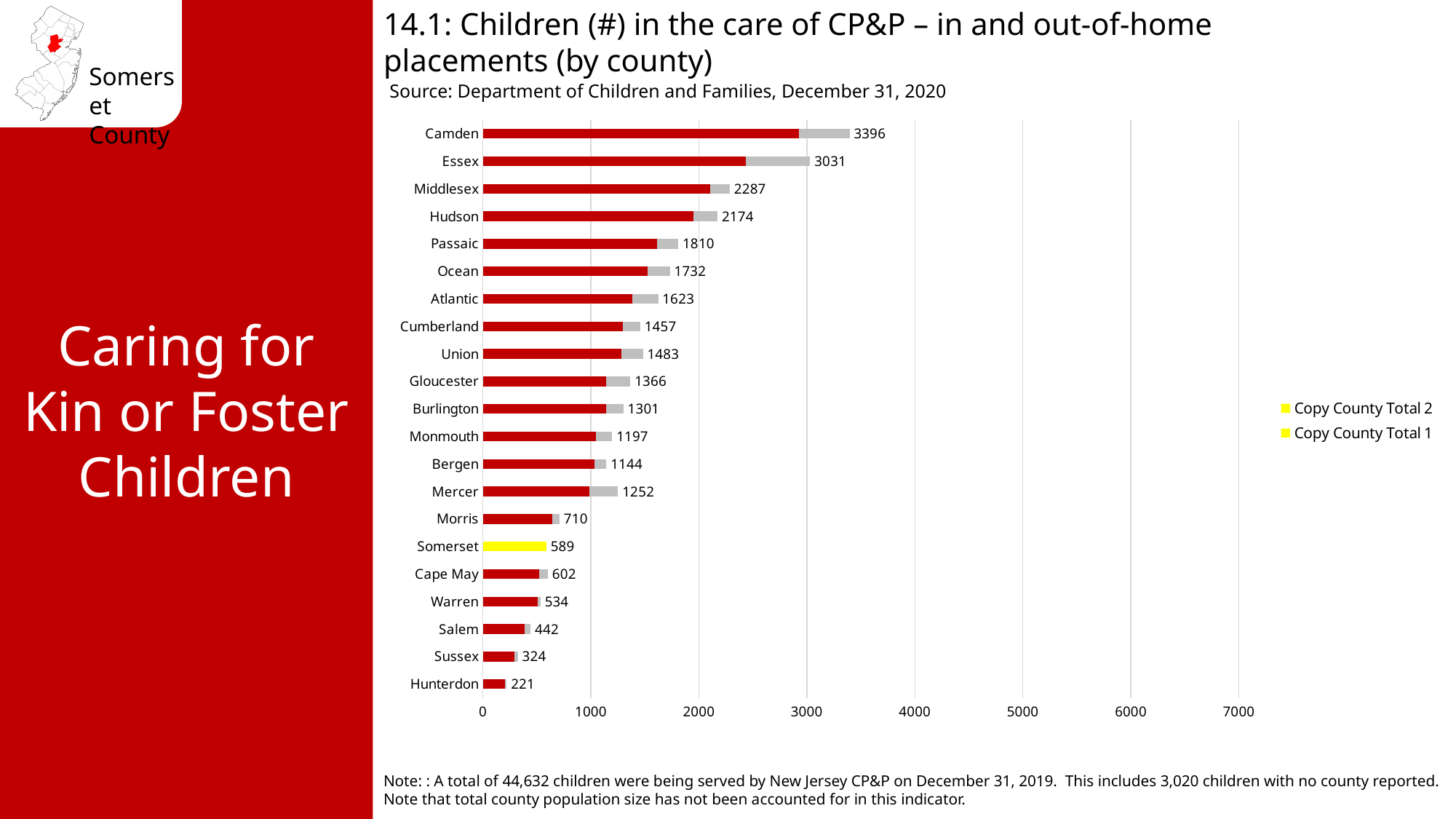
What is the total number of children in the care of CP&P for Somerset? 589 What is the total number of children in the care of CP&P for Hunterdon? 221 How many counties are shown on the chart? 21 Which county's bar is highlighted in yellow? Somerset What is the difference between the totals for Camden and Essex? 365 Which county has the lowest total number of children in the care of CP&P? Hunterdon What is the total number of children in the care of CP&P for Camden? 3396 What kind of chart is shown on the slide? Stacked bar chart Which county has the highest total number of children in the care of CP&P? Camden How many series does the legend list? 2 Which county has a larger total, Union or Cumberland? Union Is the total for Passaic greater or less than 2000? less